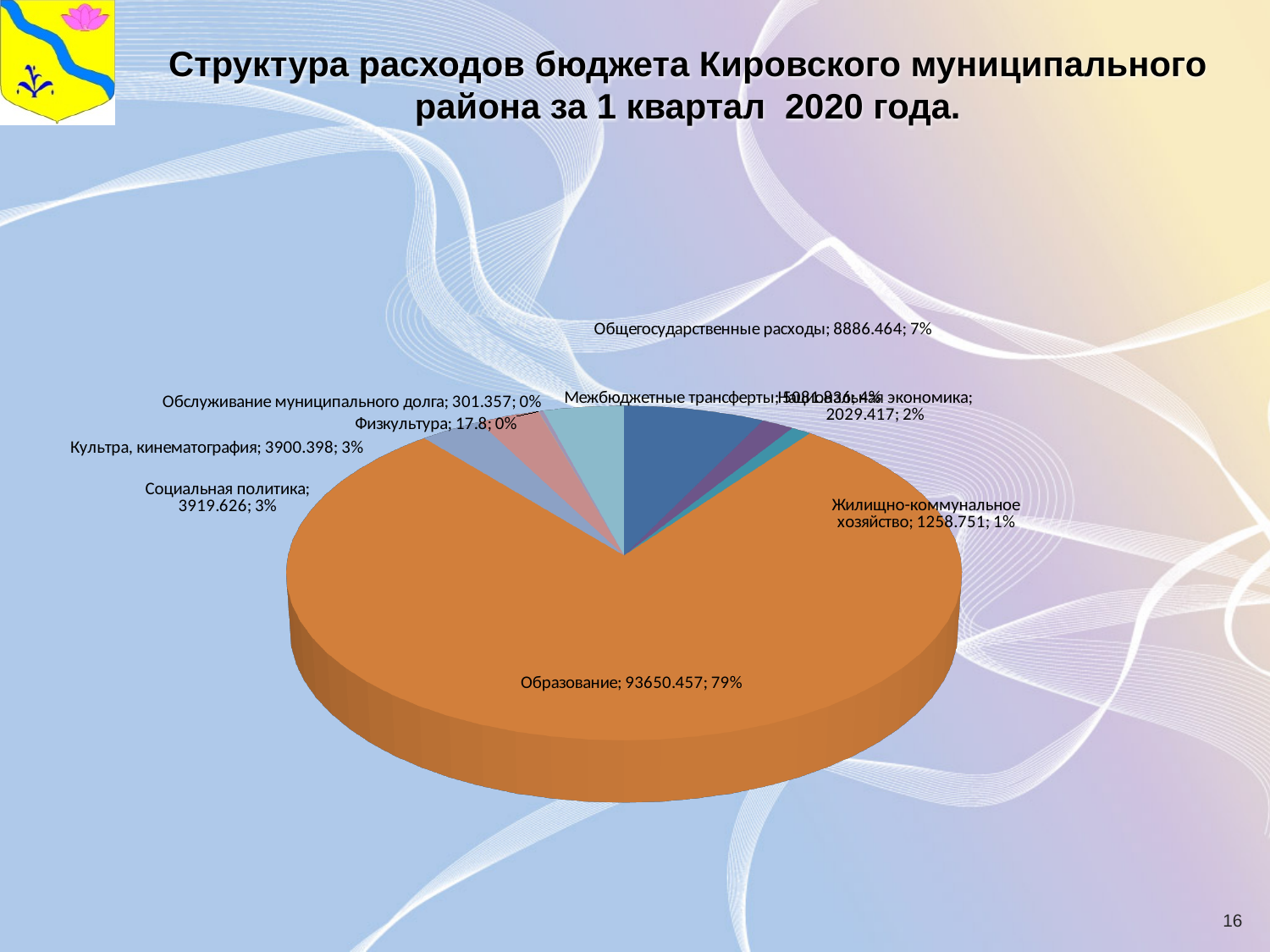
Which category has the smallest value? Физкультура What is the value for Социальная политика? 3919.626 Which is larger, Национальная экономика or Жилищно-коммунальное хозяйство? Национальная экономика What share of the pie does Общегосударственные расходы take? 7% What is the value for Общегосударственные расходы? 8886.464 Which category has the largest slice of the pie? Образование What share of the pie does Образование take? 79% What is the value for Физкультура? 17.8 What is the value for Жилищно-коммунальное хозяйство? 1258.751 What is the value for Образование? 93650.457 What kind of chart is shown on the slide? pie chart What is the title of the slide? Структура расходов бюджета Кировского муниципального района за 1 квартал 2020 года.